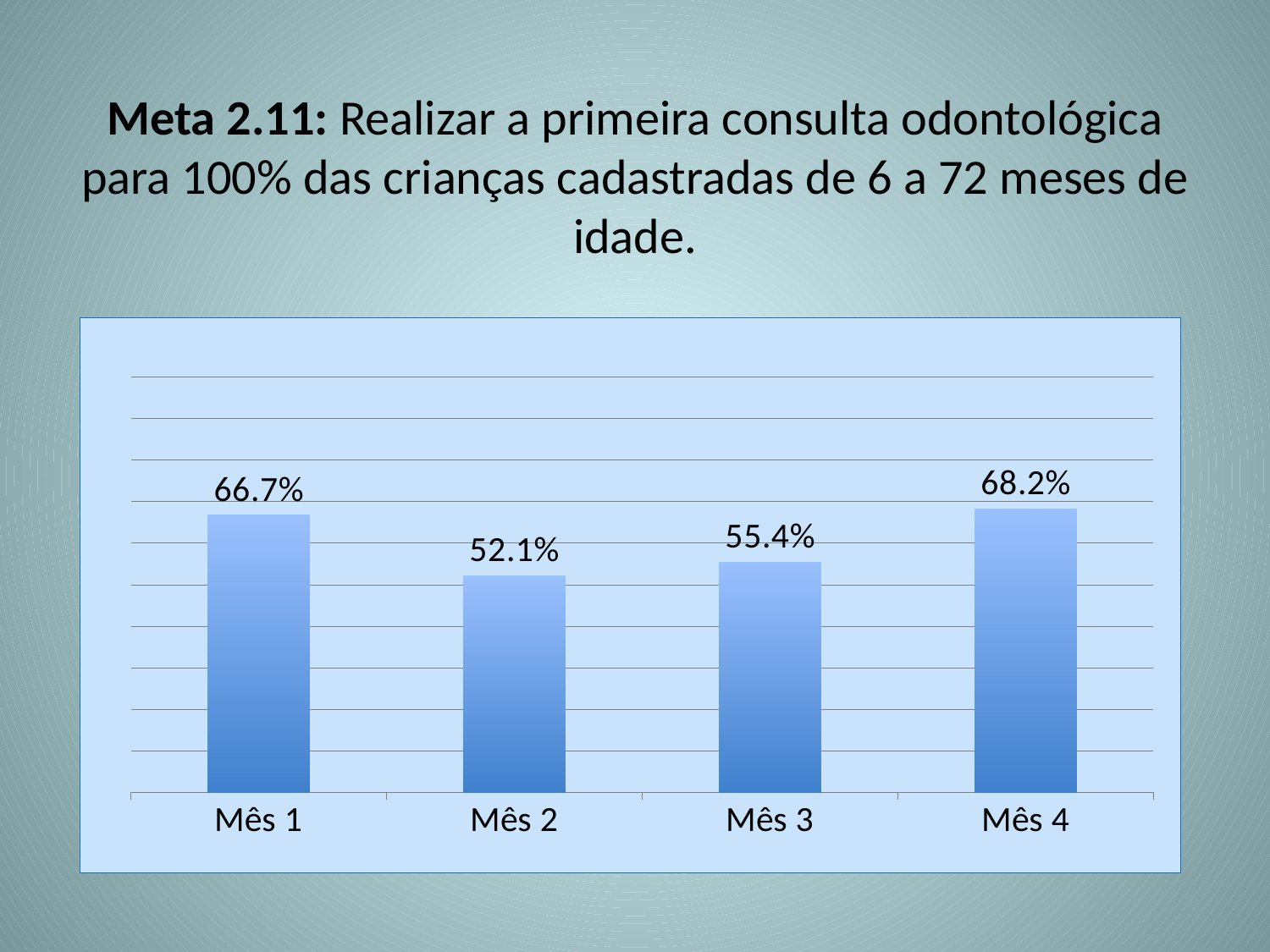
Which month has the lowest value? Mês 2 Does the value rise or fall from Mês 2 to Mês 4? Rise What is the difference between the values for Mês 1 and Mês 3? 11.3% What is the difference between the values for Mês 4 and Mês 2? 16.1% What kind of chart is shown on the slide? Bar chart Which month has the highest value? Mês 4 What is the value for Mês 2? 52.1% How many months are shown on the chart? 4 What is the value for Mês 1? 66.7% Which is larger, the value for Mês 1 or the value for Mês 3? Mês 1 What is the value for Mês 3? 55.4% What is the value for Mês 4? 68.2%